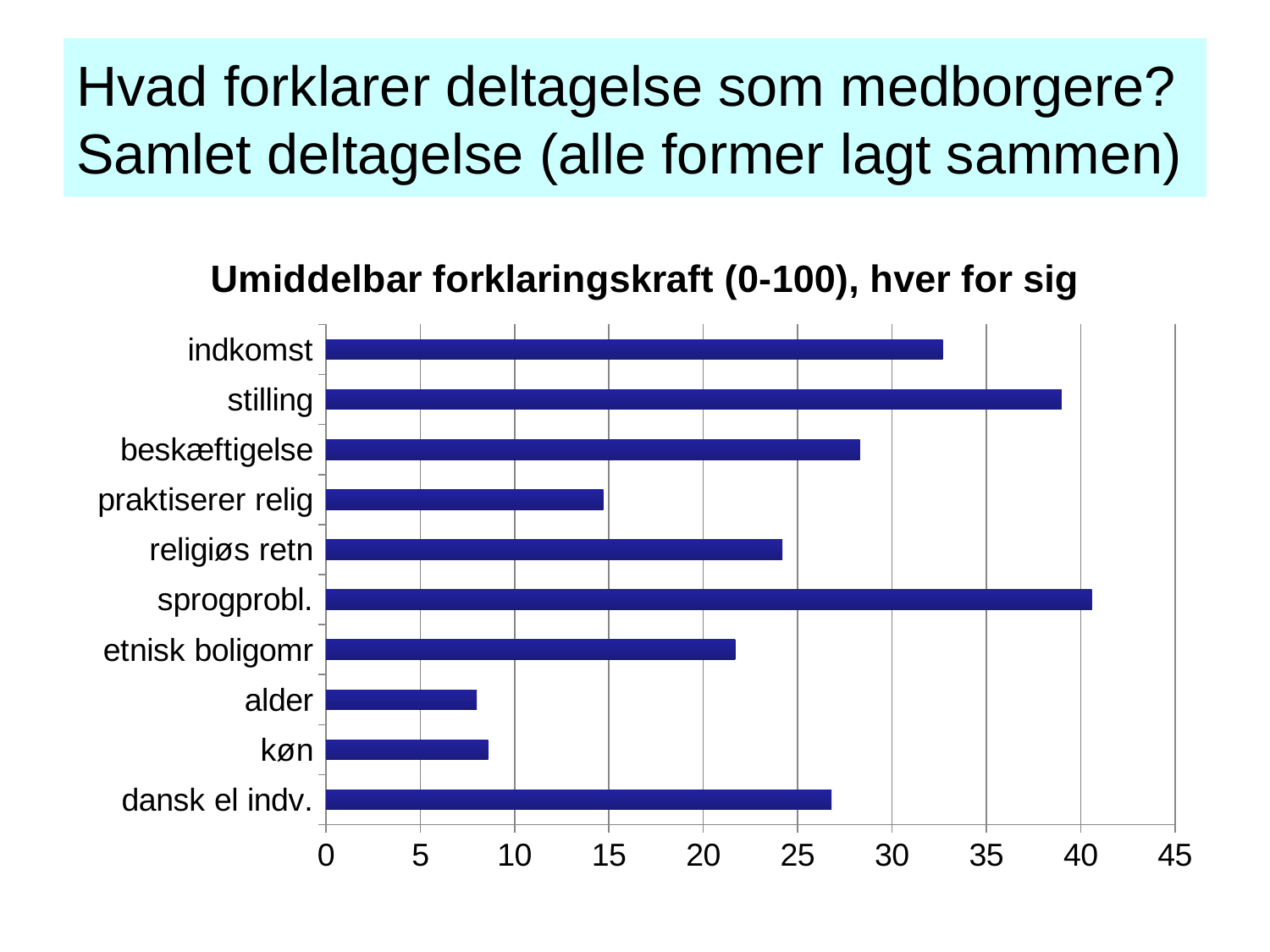
Is the value for indkomst greater or less than 30? greater Is the value for dansk el indv. greater or less than 25? greater How many categories are plotted in the chart? 10 Is the value for stilling greater or less than 40? less Which has the larger value, stilling or indkomst? stilling Which has the larger value, etnisk boligomr or praktiserer relig? etnisk boligomr Which category has the highest value in the chart? sprogprobl. What kind of chart is shown on the slide? bar chart What is the title of the chart? Umiddelbar forklaringskraft (0-100), hver for sig